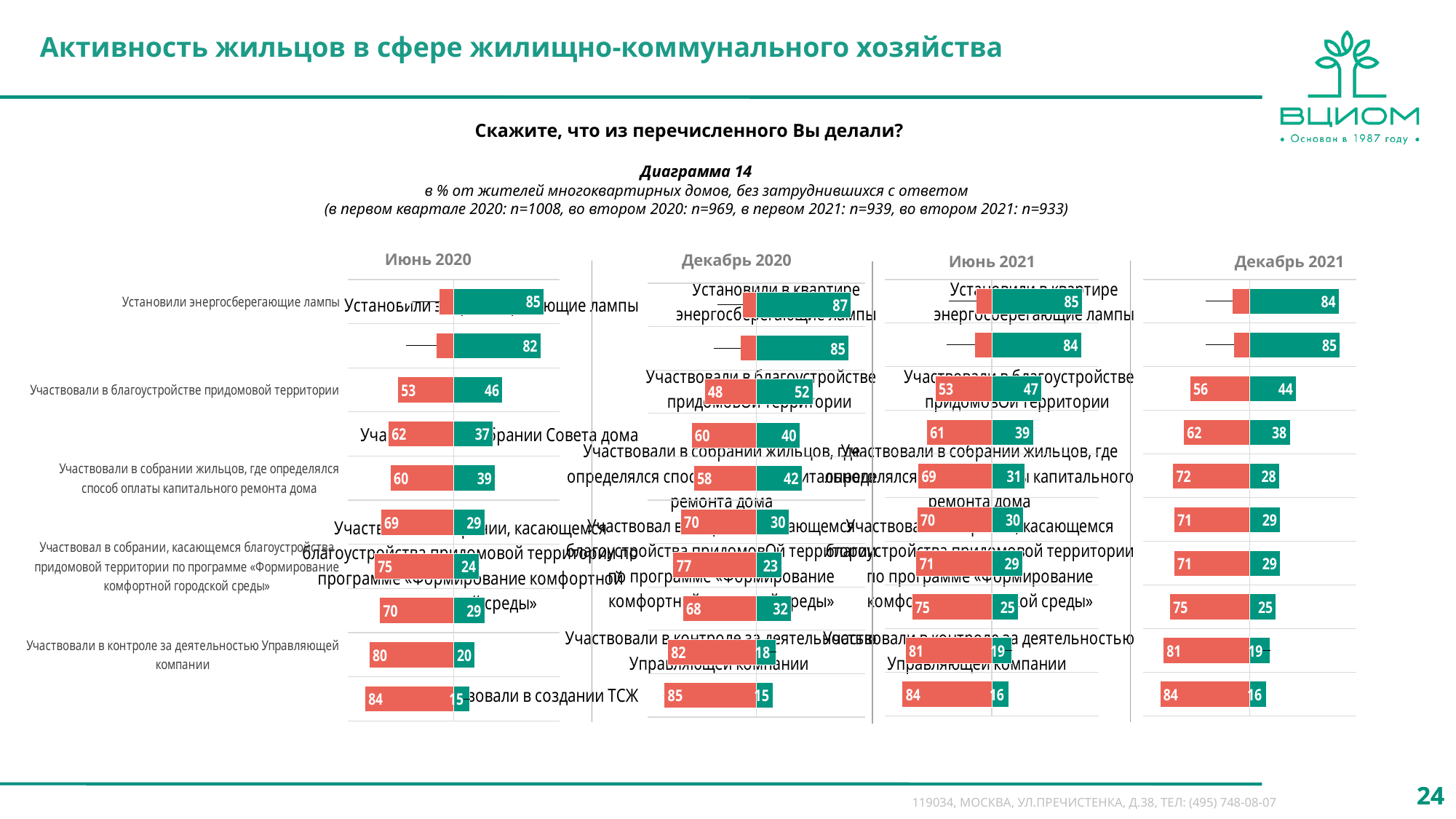
In the Декабрь 2020 chart, what is the total of the bottom stacked bar (85 red and 15 green)? 100 In the Июнь 2021 chart, what is the green value for «Установили в квартире энергосберегающие лампы»? 85 In the Декабрь 2021 chart, what is the green value of the top bar? 84 How many stacked bars does the Декабрь 2021 chart contain? 10 How many separate charts are shown on the slide? 4 What is the difference between the green value of the top bar in the Декабрь 2020 chart (87) and the green value of the top bar in the Декабрь 2021 chart (84)? 3 In the Декабрь 2021 chart, which is larger for «Участвовали в благоустройстве придомовой территории»: the red value or the green value? the red value (56) In the Декабрь 2020 chart, what is the green value for «Установили в квартире энергосберегающие лампы»? 87 What kind of chart is used on this slide? bar chart In the Декабрь 2021 chart, what is the lowest green value shown? 16 In the Июнь 2020 chart, what is the red value for «Участвовали в создании ТСЖ»? 84 What are the titles of the four charts, from left to right? Июнь 2020, Декабрь 2020, Июнь 2021, Декабрь 2021